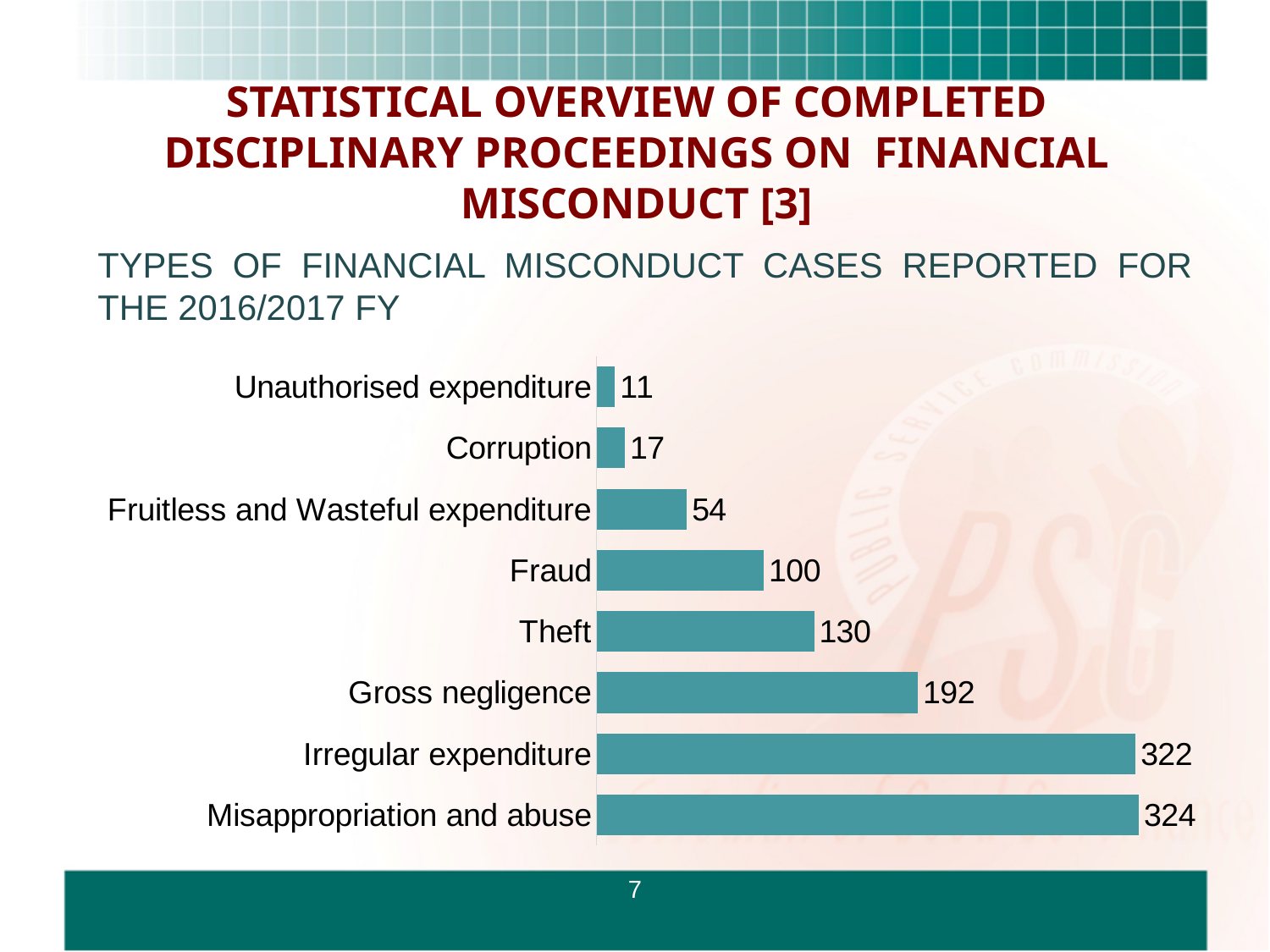
How many categories are shown in the chart? 8 What is the difference between the values for Irregular expenditure and Gross negligence? 130 What kind of chart is shown on the slide? Bar chart What is the value for Misappropriation and abuse? 324 What is the difference between the values for Theft and Fraud? 30 What is the value for Corruption? 17 Which category has the highest value? Misappropriation and abuse Which is larger, the value for Theft or the value for Fruitless and Wasteful expenditure? Theft What is the value for Gross negligence? 192 Which category has the lowest value? Unauthorised expenditure What financial year does the chart cover, according to the text above it? 2016/2017 FY What is the value for Fraud? 100